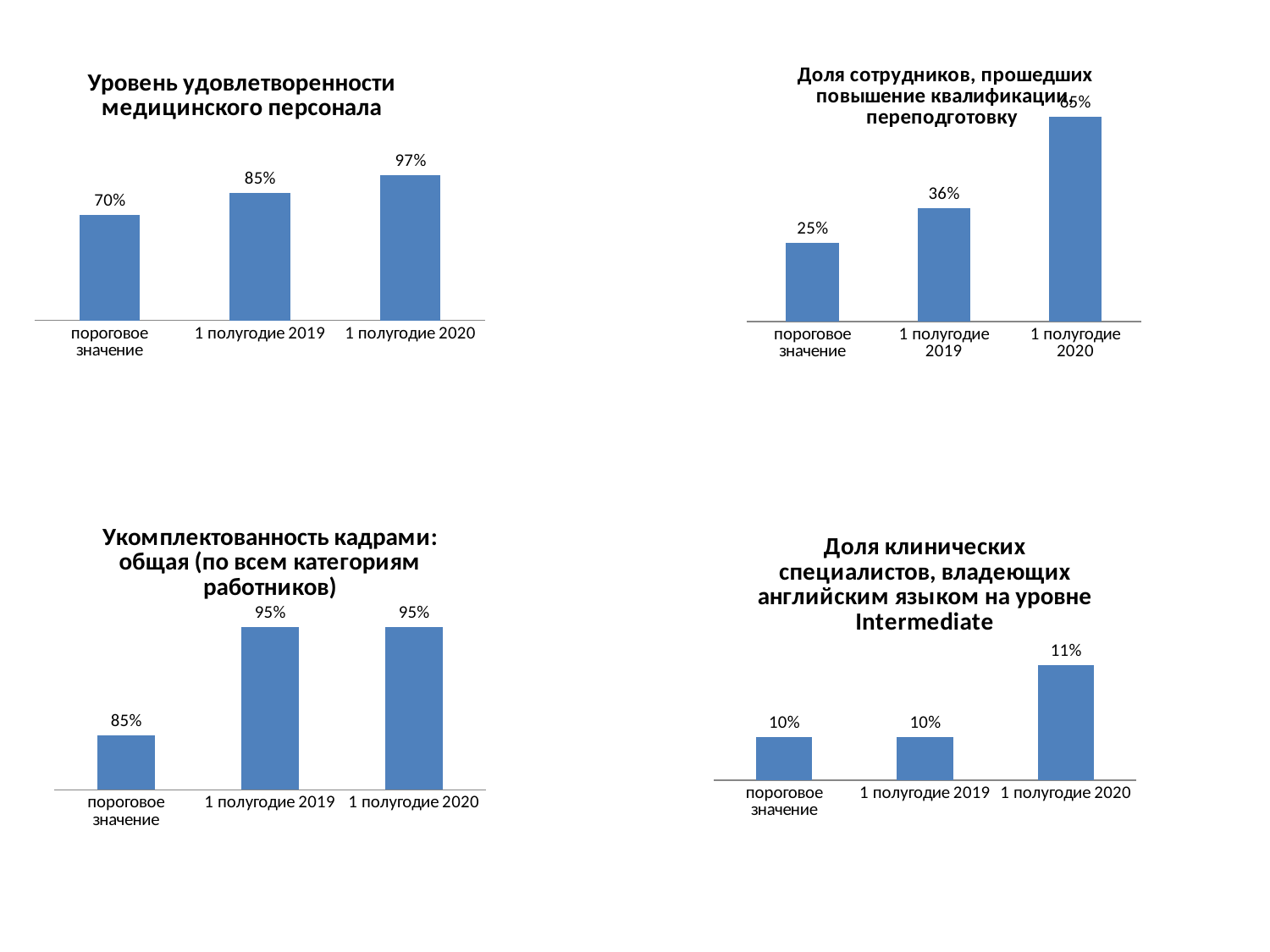
In the chart titled "Доля сотрудников, прошедших повышение квалификации, переподготовку", which category has the highest value? 1 полугодие 2020 In the chart titled "Уровень удовлетворенности медицинского персонала", what is the value for пороговое значение? 70% In the chart titled "Укомплектованность кадрами: общая (по всем категориям работников)", what is the value for 1 полугодие 2019? 95% In the chart titled "Доля клинических специалистов, владеющих английским языком на уровне Intermediate", what is the difference between 1 полугодие 2020 and пороговое значение? 1% In the chart titled "Доля сотрудников, прошедших повышение квалификации, переподготовку", which category has the lowest value? пороговое значение In the chart titled "Укомплектованность кадрами: общая (по всем категориям работников)", what is the value for пороговое значение? 85% In the chart titled "Уровень удовлетворенности медицинского персонала", what is the value for 1 полугодие 2020? 97% How many categories are shown in the chart titled "Уровень удовлетворенности медицинского персонала"? 3 In the chart titled "Доля клинических специалистов, владеющих английским языком на уровне Intermediate", what is the value for 1 полугодие 2020? 11% In the chart titled "Уровень удовлетворенности медицинского персонала", what is the difference between 1 полугодие 2020 and 1 полугодие 2019? 12% In the chart titled "Доля сотрудников, прошедших повышение квалификации, переподготовку", what is the value for 1 полугодие 2019? 36% What type of chart is the chart titled "Укомплектованность кадрами: общая (по всем категориям работников)"? Bar chart